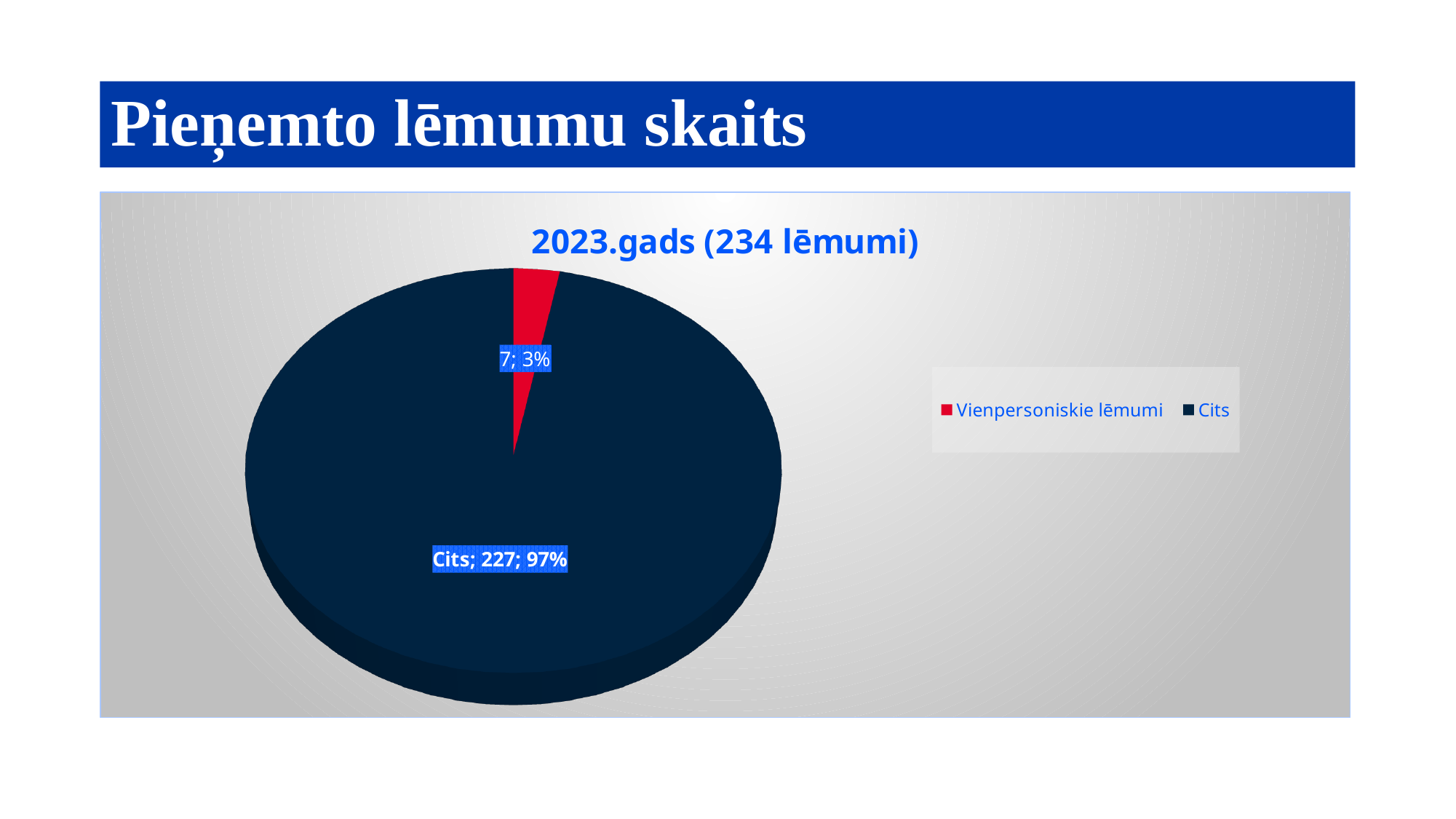
What is the difference between the values for Cits and Vienpersoniskie lēmumi? 220 What kind of chart is shown on the slide? pie chart How many entries does the legend list? 2 What share of the pie does Cits represent? 97% What is the title of the chart? 2023.gads (234 lēmumi) What share of the pie does Vienpersoniskie lēmumi represent? 3% What is the value for Cits? 227 How many slices does the pie chart have? 2 What colour is the slice for Vienpersoniskie lēmumi? red What is the value for Vienpersoniskie lēmumi? 7 Which category has the smallest slice? Vienpersoniskie lēmumi Which category has the largest slice? Cits